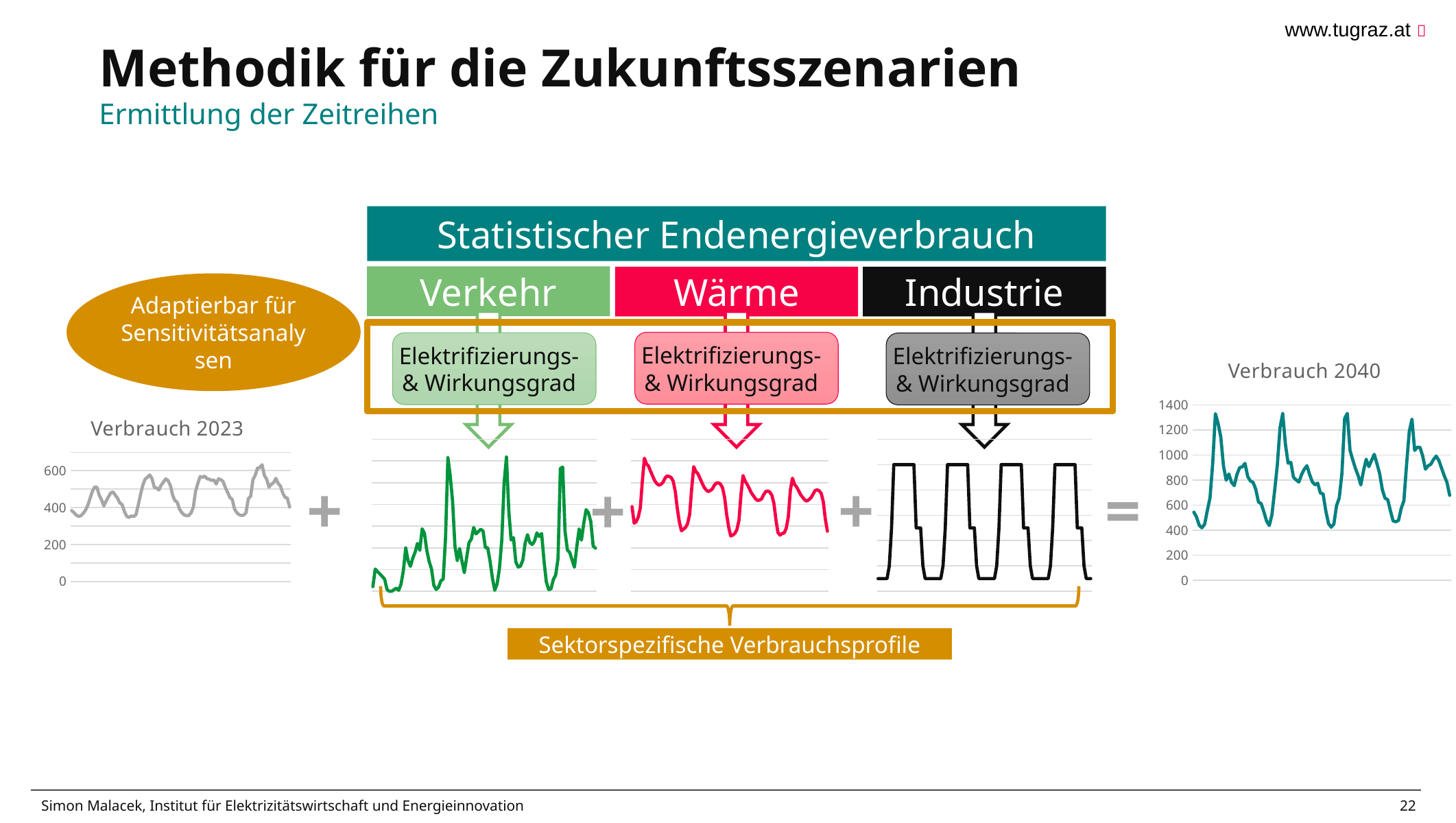
What kind of chart is the "Verbrauch 2040" chart on the right of the slide? line chart What is the highest tick value shown on the y axis of the "Verbrauch 2023" chart? 600 In the "Verbrauch 2040" chart, is the highest peak of the line greater or less than 1200? greater How many line charts are shown on the slide in total? 5 In the "Verbrauch 2023" chart, is the lowest point of the line greater or less than 400? less What is the highest tick value shown on the y axis of the "Verbrauch 2040" chart? 1400 In the "Verbrauch 2040" chart, is the lowest point of the line greater or less than 600? less Which chart has the higher y-axis maximum, "Verbrauch 2023" or "Verbrauch 2040"? Verbrauch 2040 What is the title of the line chart on the far right of the slide? Verbrauch 2040 What kind of chart is the "Verbrauch 2023" chart on the left of the slide? line chart